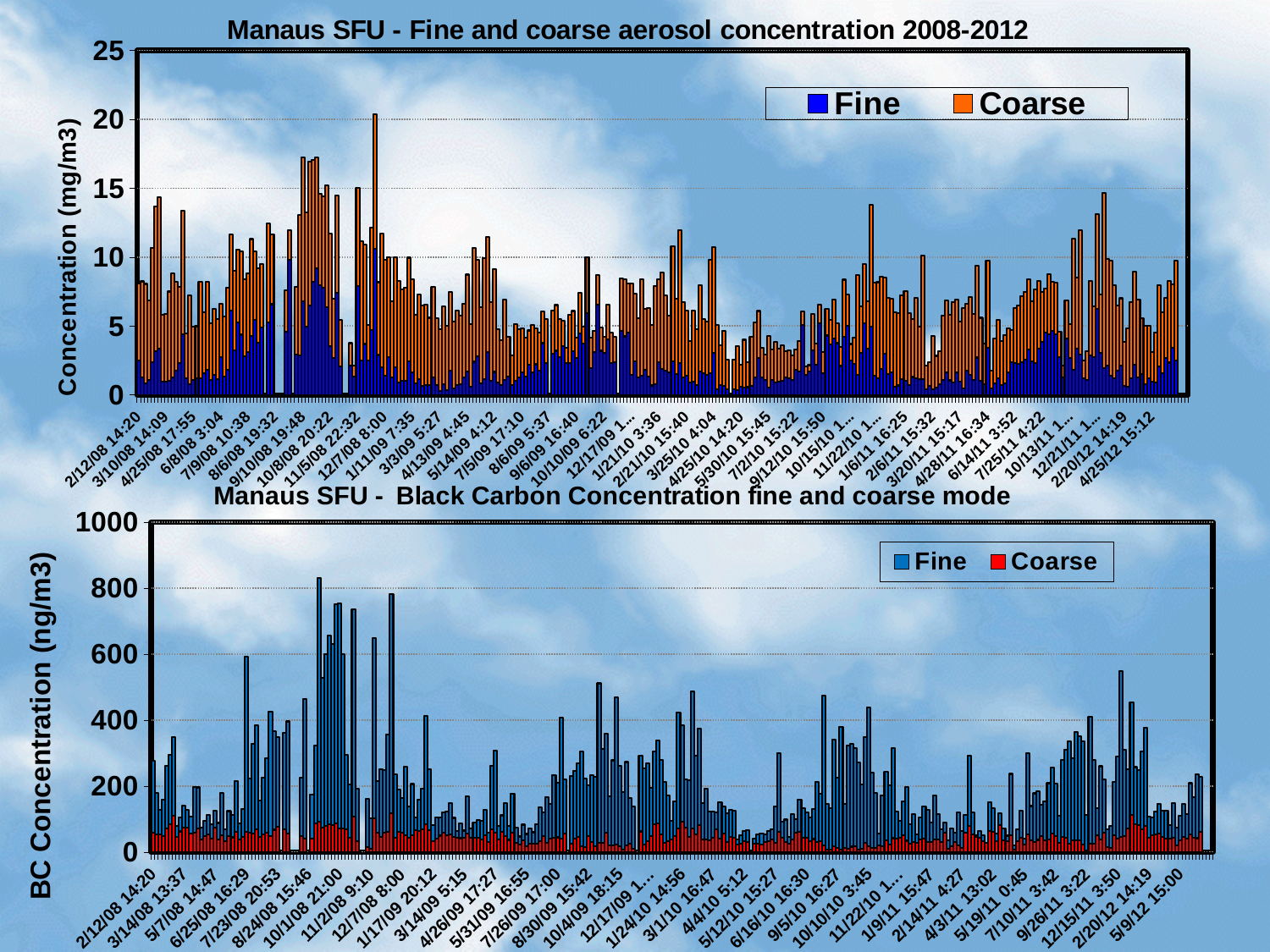
What is the title of the top chart? Manaus SFU - Fine and coarse aerosol concentration 2008-2012 What is the y-axis label of the bottom chart? BC Concentration (ng/m3) What kind of chart is the top chart, 'Manaus SFU - Fine and coarse aerosol concentration 2008-2012'? Stacked bar chart How many series does the legend of the bottom chart list? 2 What kind of chart is the bottom chart, 'Manaus SFU - Black Carbon Concentration fine and coarse mode'? Stacked bar chart What is the title of the bottom chart? Manaus SFU - Black Carbon Concentration fine and coarse mode In the top chart, which series generally contributes more to each bar, Fine or Coarse? Coarse In the top chart, is the maximum value shown on the y-axis greater or less than 20? greater How many series does the legend of the top chart list? 2 In the top chart, is the tallest stacked bar greater or less than 15 mg/m3? greater In the bottom chart, which series generally contributes more to each bar, Fine or Coarse? Fine In the bottom chart, is the tallest stacked bar greater or less than 600 ng/m3? greater